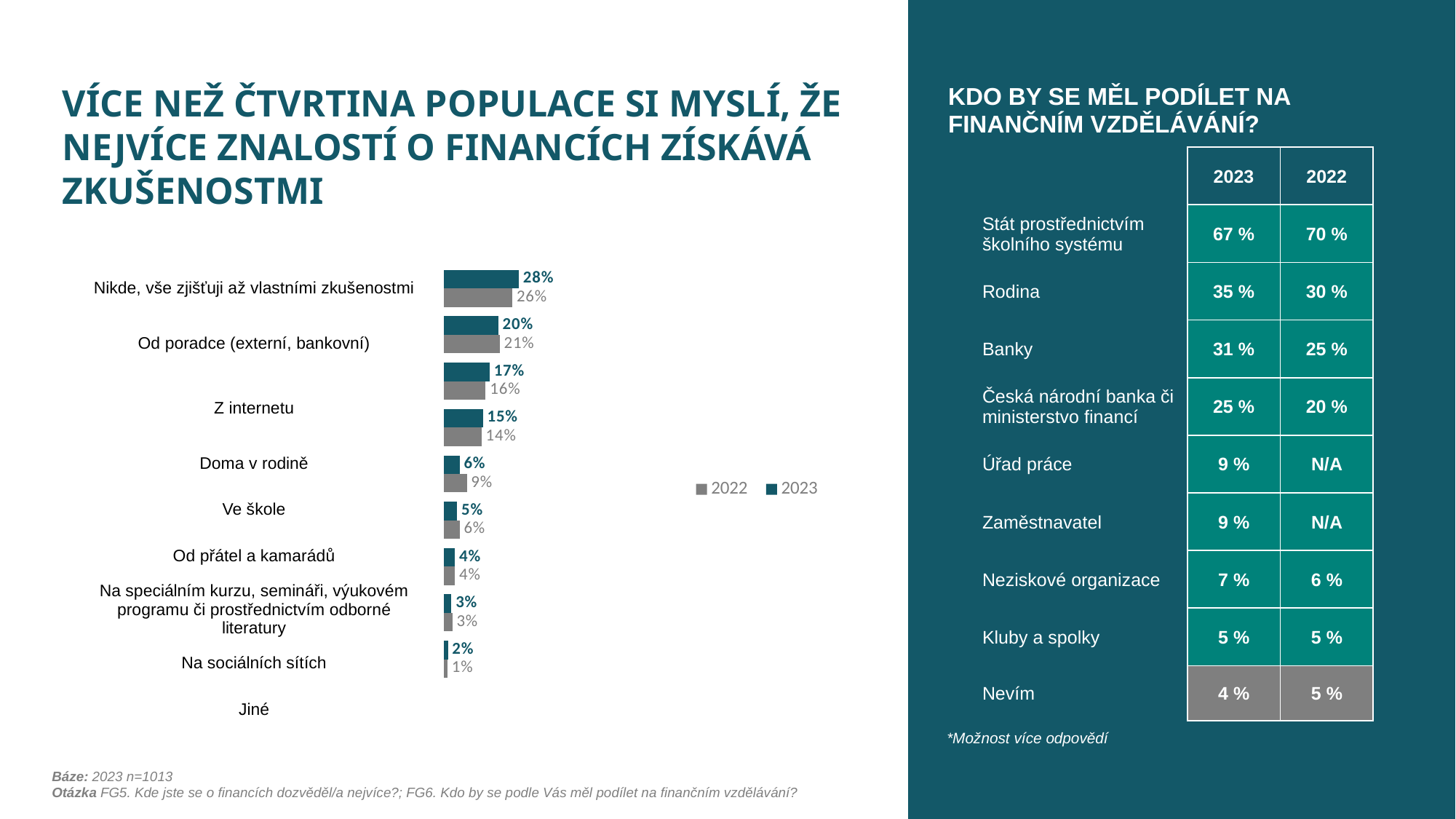
In the bar chart, which year has the larger value for "Nikde, vše zjišťuji až vlastními zkušenostmi", 2022 or 2023? 2023 How many categories are shown in the bar chart? 9 In the bar chart, by how many percentage points does the 2023 value for "Nikde, vše zjišťuji až vlastními zkušenostmi" exceed the 2022 value? 2 In the bar chart, what is the 2022 value for "Nikde, vše zjišťuji až vlastními zkušenostmi"? 26% In the bar chart, which year has the larger value for "Od poradce (externí, bankovní)", 2022 or 2023? 2022 In the bar chart, what is the 2022 value for "Od poradce (externí, bankovní)"? 21% What type of chart is shown on the left of the slide? bar chart Which series does the legend of the bar chart list? 2022 and 2023 In the bar chart, what is the 2023 value for "Od poradce (externí, bankovní)"? 20% In the bar chart, what is the 2023 value for "Nikde, vše zjišťuji až vlastními zkušenostmi"? 28% In the bar chart, which category has the highest 2023 value? Nikde, vše zjišťuji až vlastními zkušenostmi How many series does the legend of the bar chart list? 2